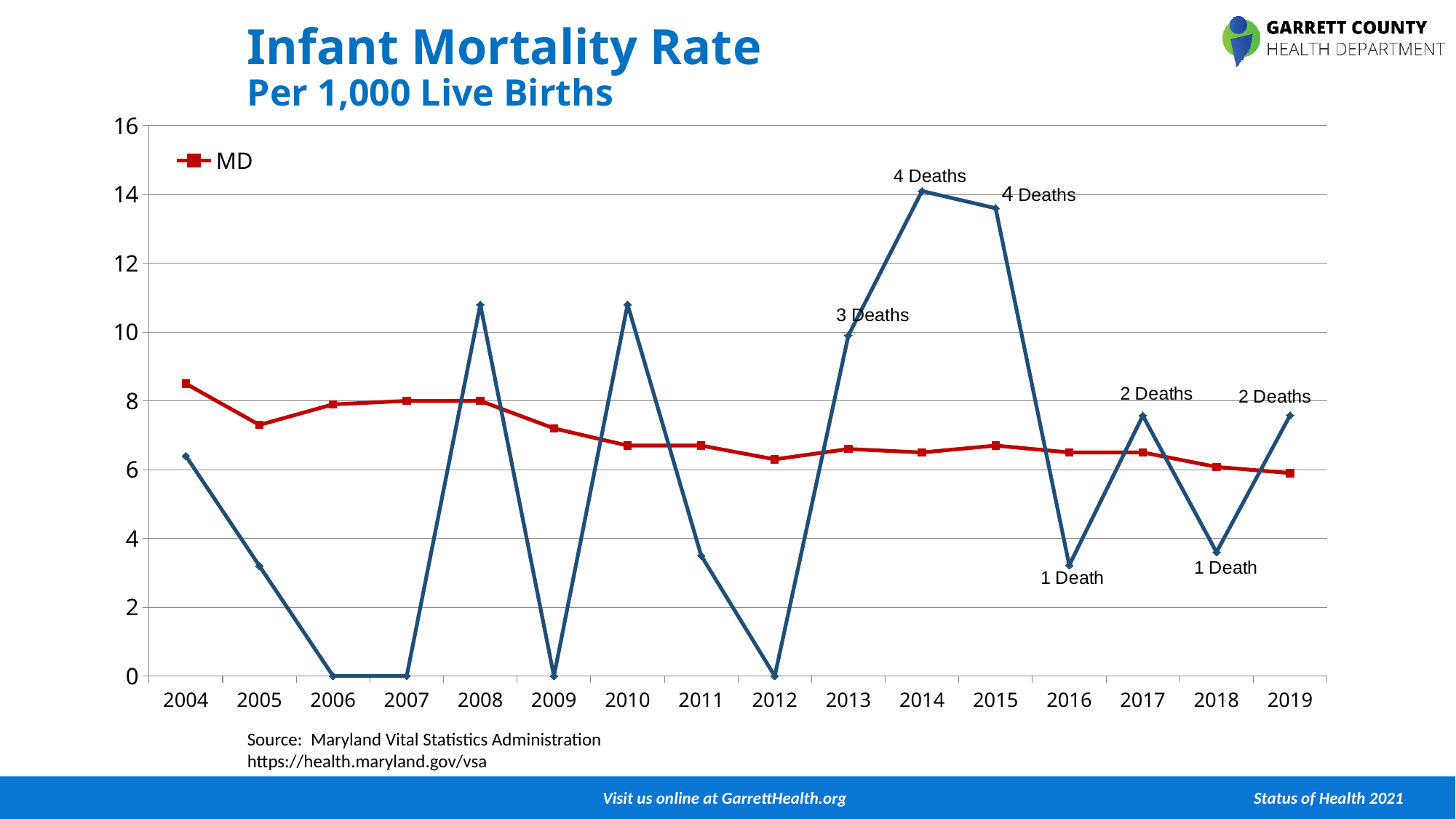
What is the value of the blue line in 2006? 0 Is the value of the blue line in 2014 greater or less than 12? greater In which year does the blue line reach its highest value? 2014 How many years are shown along the x axis of the chart? 16 What data label is shown on the blue line at 2016? 1 Death What is the value of the blue line in 2012? 0 In which year does the MD line reach its highest value? 2004 What kind of chart is shown on the slide? line chart Is the MD value for 2004 greater or less than 8? greater Is the value of the blue line in 2011 greater or less than 4? less How many series does the chart's legend list? 1 In 2014, which is higher: the blue line or the MD line? the blue line